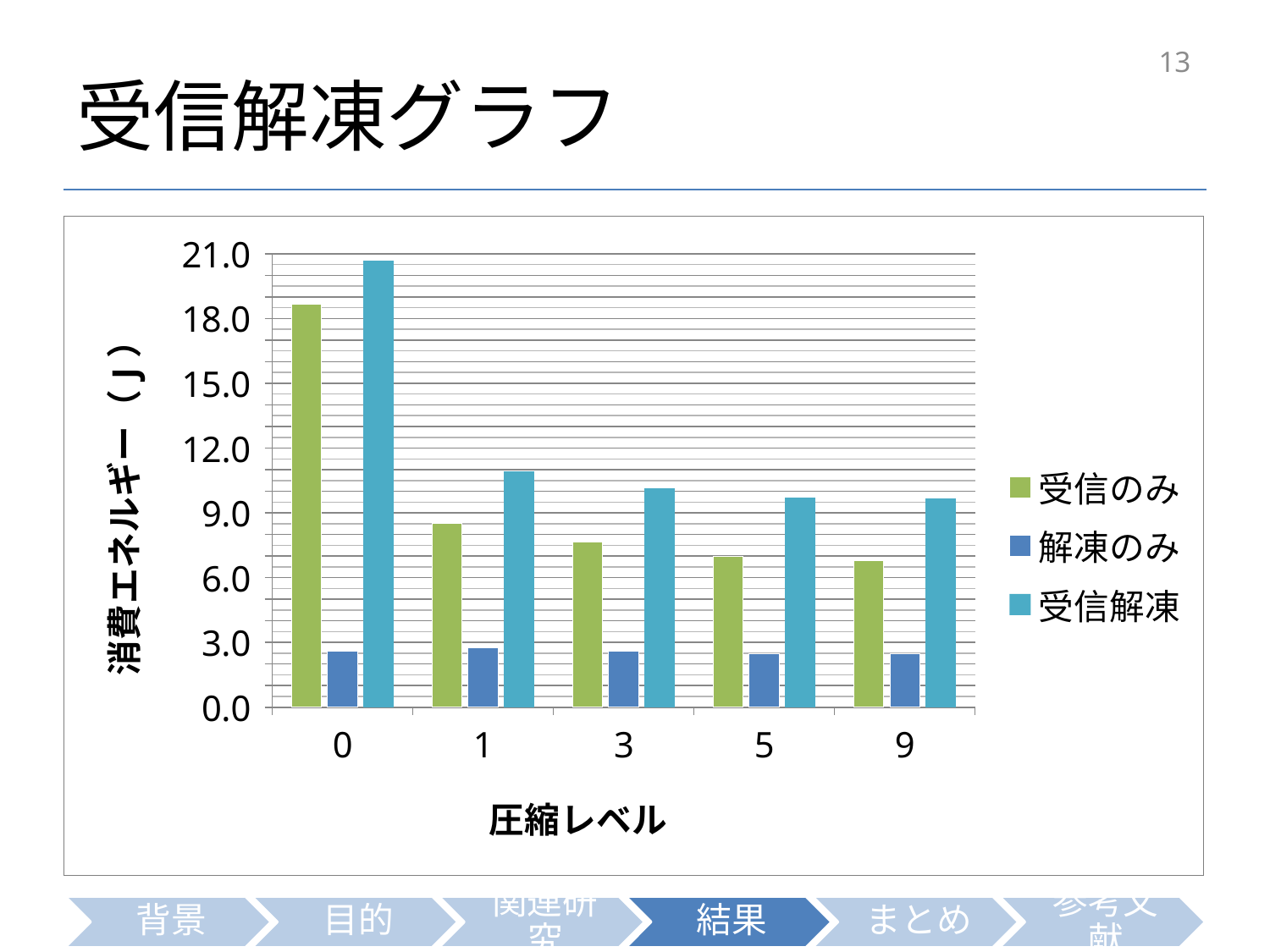
Is the 受信解凍 value at compression level 0 greater or less than 18.0? greater Is the 受信解凍 value at compression level 1 greater or less than 9.0? greater How many compression levels (圧縮レベル) are shown on the x axis? 5 What kind of chart is shown on the slide? bar chart Is the 受信のみ value at compression level 1 greater or less than 9.0? less How many series does the legend list? 3 Do the 受信解凍 values rise or fall as the compression level increases from 0 to 9? fall At which compression level is the 受信のみ value highest? 0 At compression level 3, which is larger: 受信のみ or 受信解凍? 受信解凍 At which compression level is the 受信解凍 value highest? 0 What is the title of the y axis? 消費エネルギー（J）